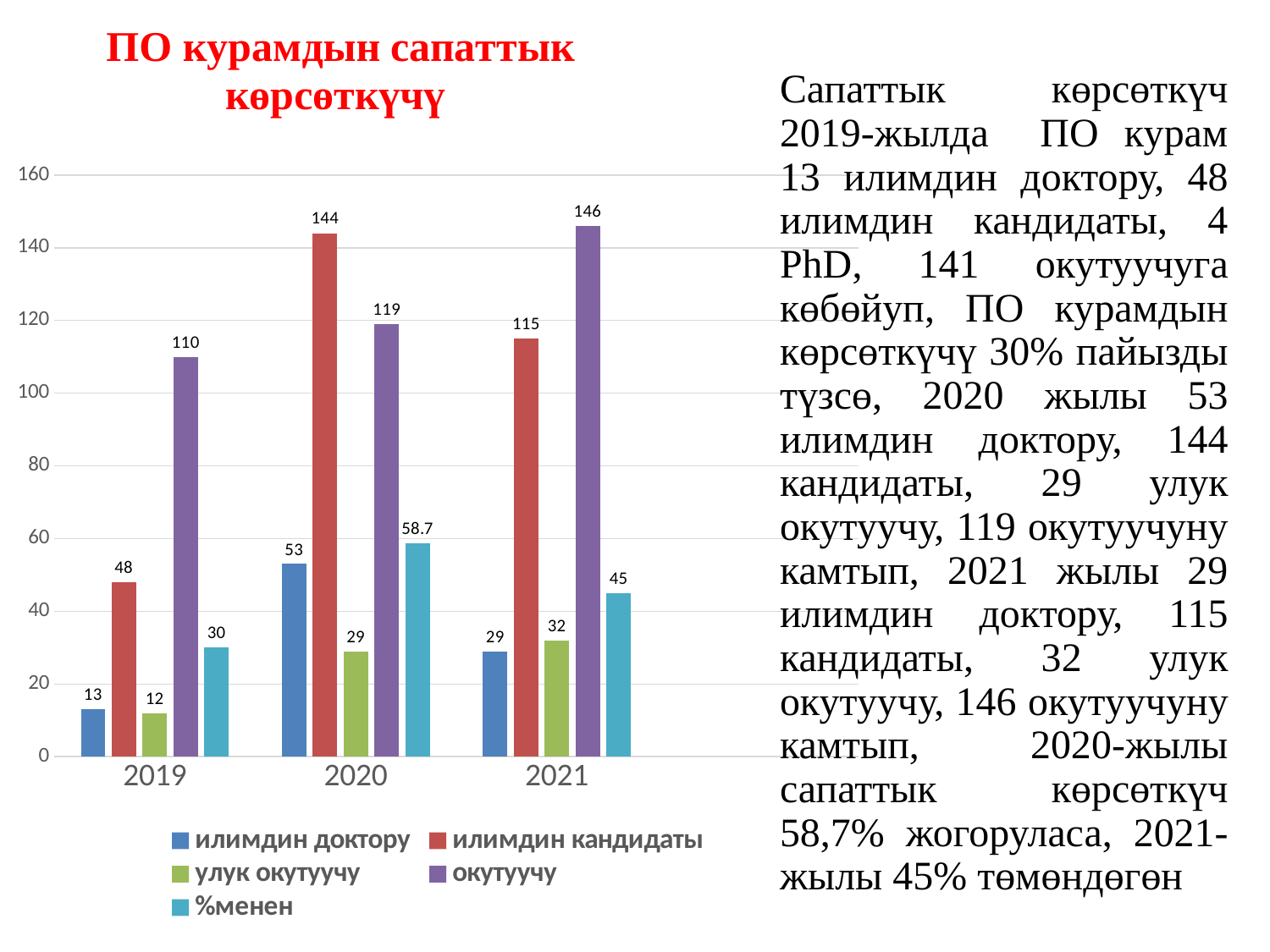
What is the title of the chart? ПО курамдын сапаттык көрсөткүчү What is the value for илимдин кандидаты in 2020? 144 What type of chart is shown on the slide? bar chart How many series does the legend list? 5 Which is larger: илимдин кандидаты in 2020 or илимдин кандидаты in 2021? 2020 In which year is the value for улук окутуучу lowest? 2019 What is the difference between the окутуучу values for 2021 and 2019? 36 What is the value for окутуучу in 2021? 146 What is the value for %менен in 2020? 58.7 In which year is the value for илимдин доктору highest? 2020 How many year categories are shown on the x axis? 3 Does the value for окутуучу rise or fall from 2019 to 2021? rise